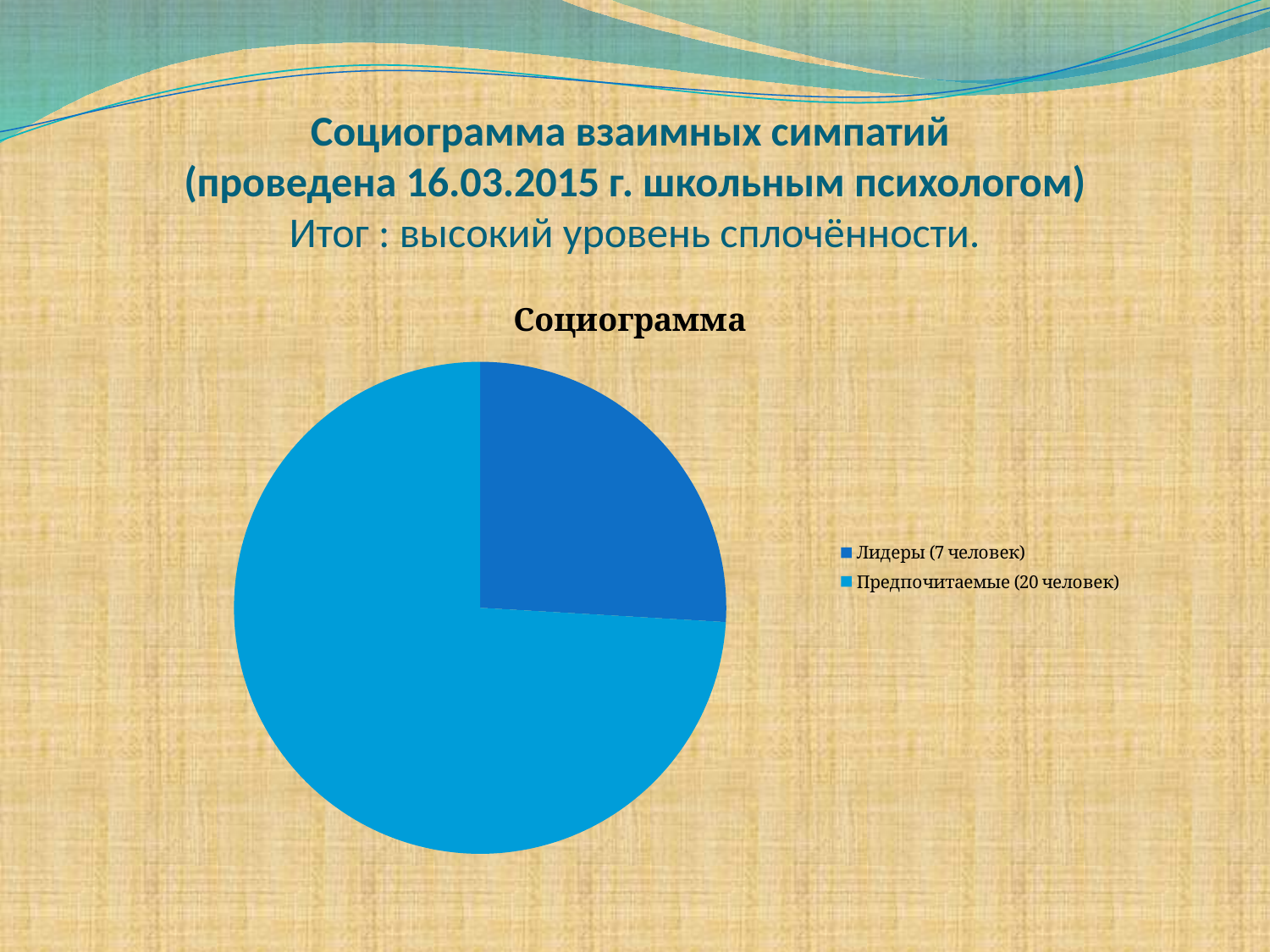
Which legend entry is shown in the darker blue colour? Лидеры (7 человек) What kind of chart is shown on the slide? pie chart How many people are in the "Предпочитаемые" group according to the legend? 20 человек How many people are in the "Лидеры" group according to the legend? 7 человек What is the total number of people represented in the pie chart? 27 What is the difference between the number of "Предпочитаемые" and the number of "Лидеры"? 13 Which is larger: the number of "Лидеры" or the number of "Предпочитаемые"? Предпочитаемые How many entries does the legend list? 2 What is the title of the chart? Социограмма Which group has the larger slice of the pie? Предпочитаемые (20 человек) Which group has the smaller slice of the pie? Лидеры (7 человек) How many slices does the pie chart have? 2